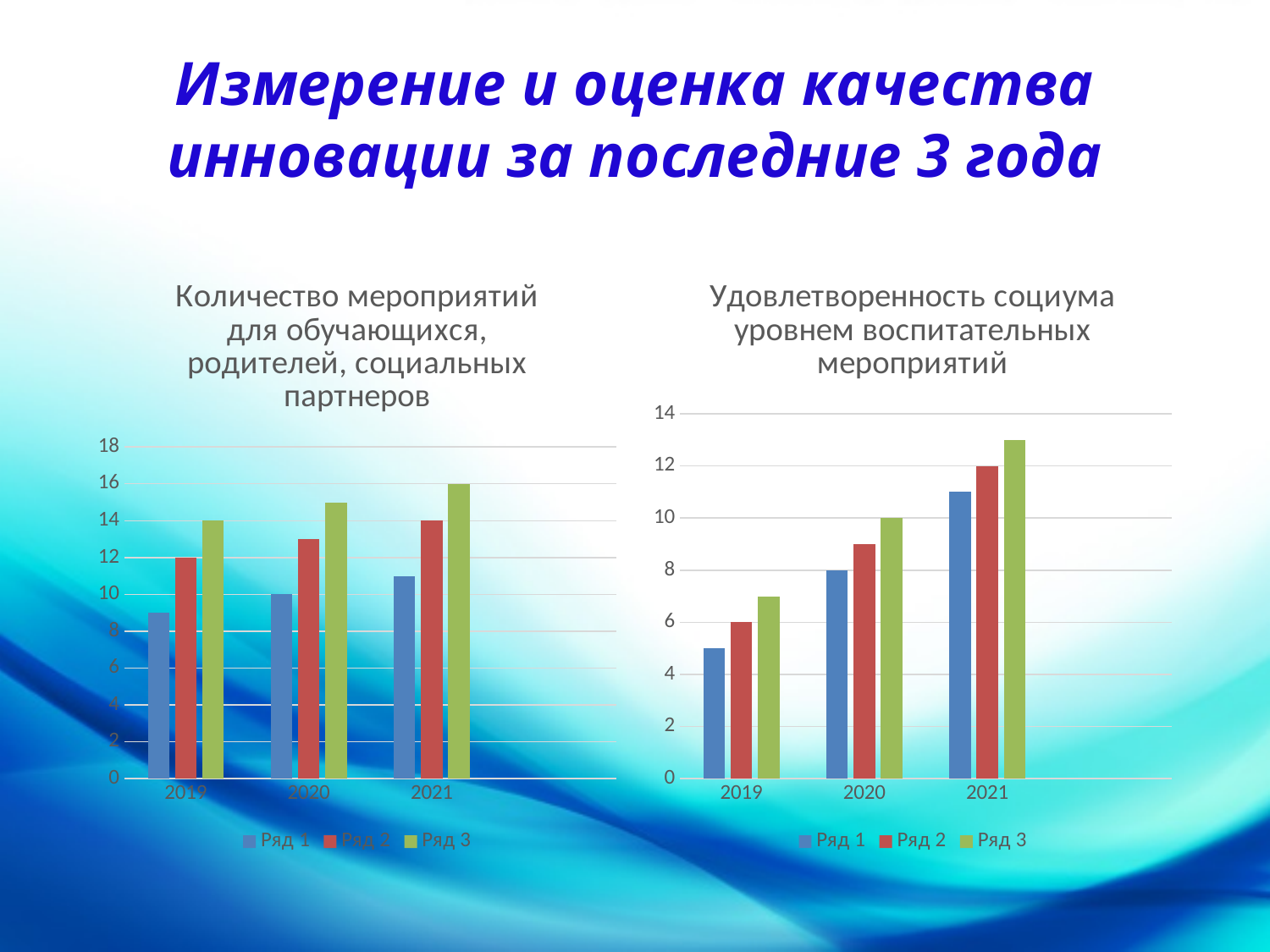
In the right chart, is the value for Ряд 2 in 2021 greater or less than 10? greater In the right chart, 'Удовлетворенность социума уровнем воспитательных мероприятий', which year has the highest value for Ряд 3? 2021 In the left chart, do the values for Ряд 1 rise or fall from 2019 to 2021? rise In the right chart, do the values for Ряд 2 rise or fall from 2019 to 2021? rise How many series does the legend of the right chart, 'Удовлетворенность социума уровнем воспитательных мероприятий', list? 3 What is the title of the right chart? Удовлетворенность социума уровнем воспитательных мероприятий In the left chart, which is larger in 2020: Ряд 1 or Ряд 3? Ряд 3 What kind of chart is the left chart, 'Количество мероприятий для обучающихся, родителей, социальных партнеров'? bar chart In the left chart, 'Количество мероприятий для обучающихся, родителей, социальных партнеров', which year has the lowest value for Ряд 1? 2019 In the left chart, is the value for Ряд 3 in 2021 greater or less than 14? greater How many year categories are shown on the x axis of the left chart? 3 In the right chart, is the value for Ряд 1 in 2019 greater or less than 6? less